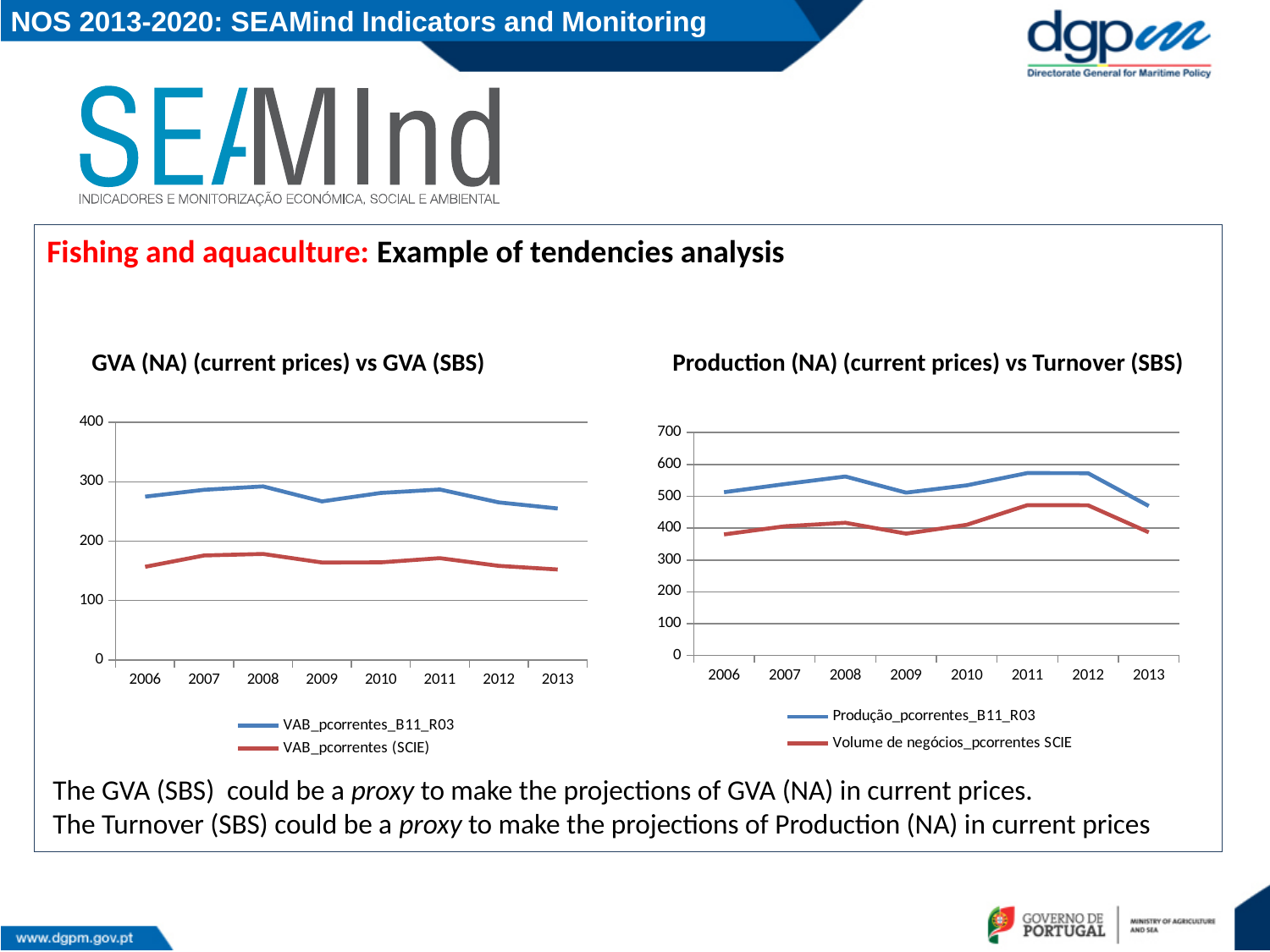
In the left chart 'GVA (NA) (current prices) vs GVA (SBS)', is the value of VAB_pcorrentes (SCIE) in 2013 greater or less than 200? less What is the title of the right chart on the slide? Production (NA) (current prices) vs Turnover (SBS) What kind of chart is the left chart titled 'GVA (NA) (current prices) vs GVA (SBS)'? line chart In the left chart 'GVA (NA) (current prices) vs GVA (SBS)', which series has the larger value in 2010, VAB_pcorrentes_B11_R03 or VAB_pcorrentes (SCIE)? VAB_pcorrentes_B11_R03 How many years are plotted on the x axis of the left chart 'GVA (NA) (current prices) vs GVA (SBS)'? 8 In the right chart 'Production (NA) (current prices) vs Turnover (SBS)', which year has the lowest value for Produção_pcorrentes_B11_R03? 2013 In the left chart 'GVA (NA) (current prices) vs GVA (SBS)', is the value of VAB_pcorrentes_B11_R03 in 2008 greater or less than 200? greater In the left chart 'GVA (NA) (current prices) vs GVA (SBS)', what colour is the line for VAB_pcorrentes (SCIE)? red In the right chart 'Production (NA) (current prices) vs Turnover (SBS)', does the Produção_pcorrentes_B11_R03 line rise or fall from 2012 to 2013? fall How many series does the legend of the right chart 'Production (NA) (current prices) vs Turnover (SBS)' list? 2 In the right chart 'Production (NA) (current prices) vs Turnover (SBS)', is the value of Produção_pcorrentes_B11_R03 in 2013 greater or less than 500? less